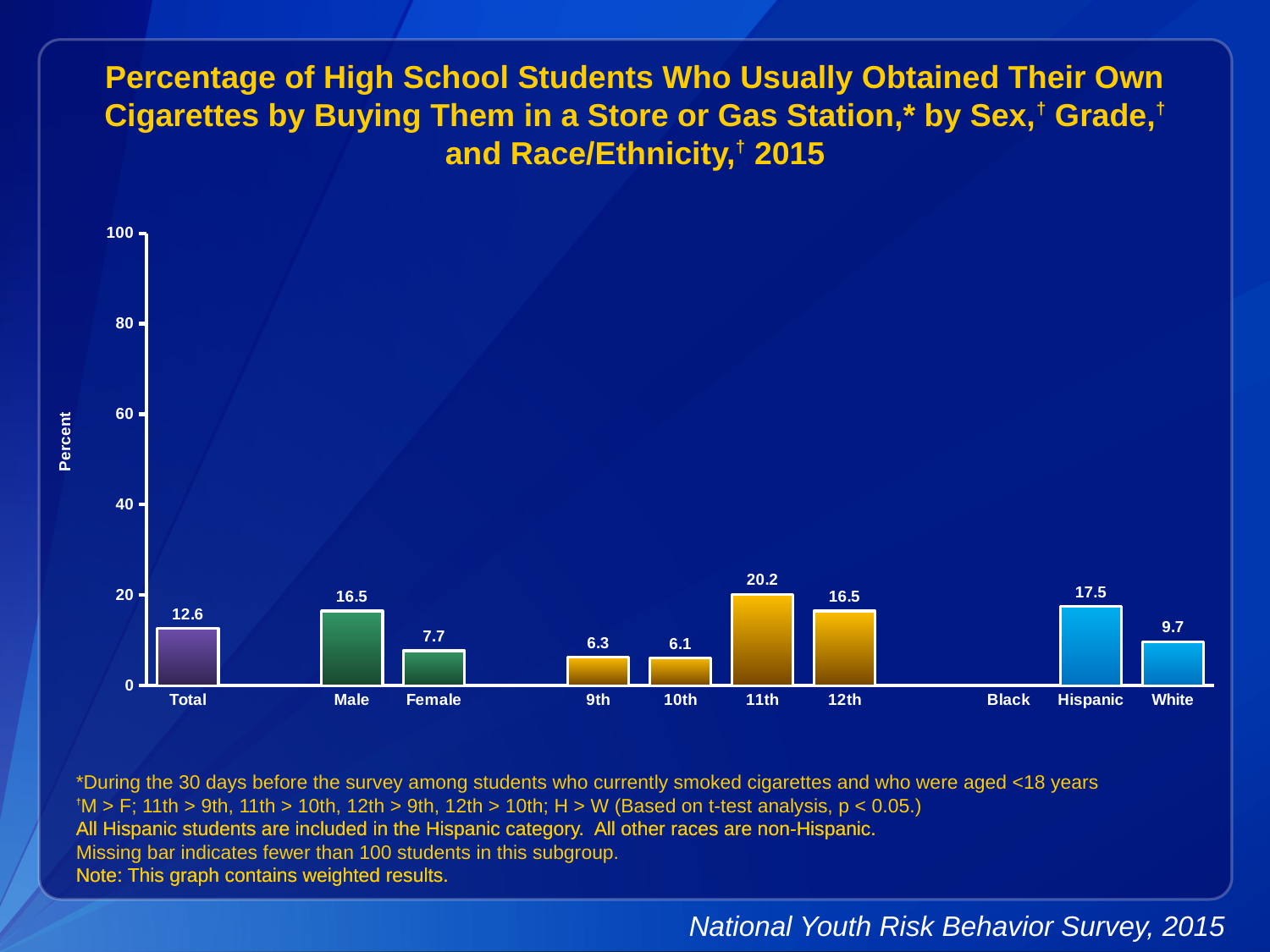
Which category with a plotted bar has the lowest value? 10th What is the value for Male? 16.5 What is the value for Hispanic? 17.5 How many categories are labeled on the x axis? 10 Which is larger, the value for Hispanic or the value for White? Hispanic What is the label of the y axis? Percent Which category has the highest value? 11th Is the value for 11th greater or less than 20? greater Which category has no bar plotted? Black What kind of chart is shown? bar chart What is the difference between the Male and Female values? 8.8 What is the value for Total? 12.6